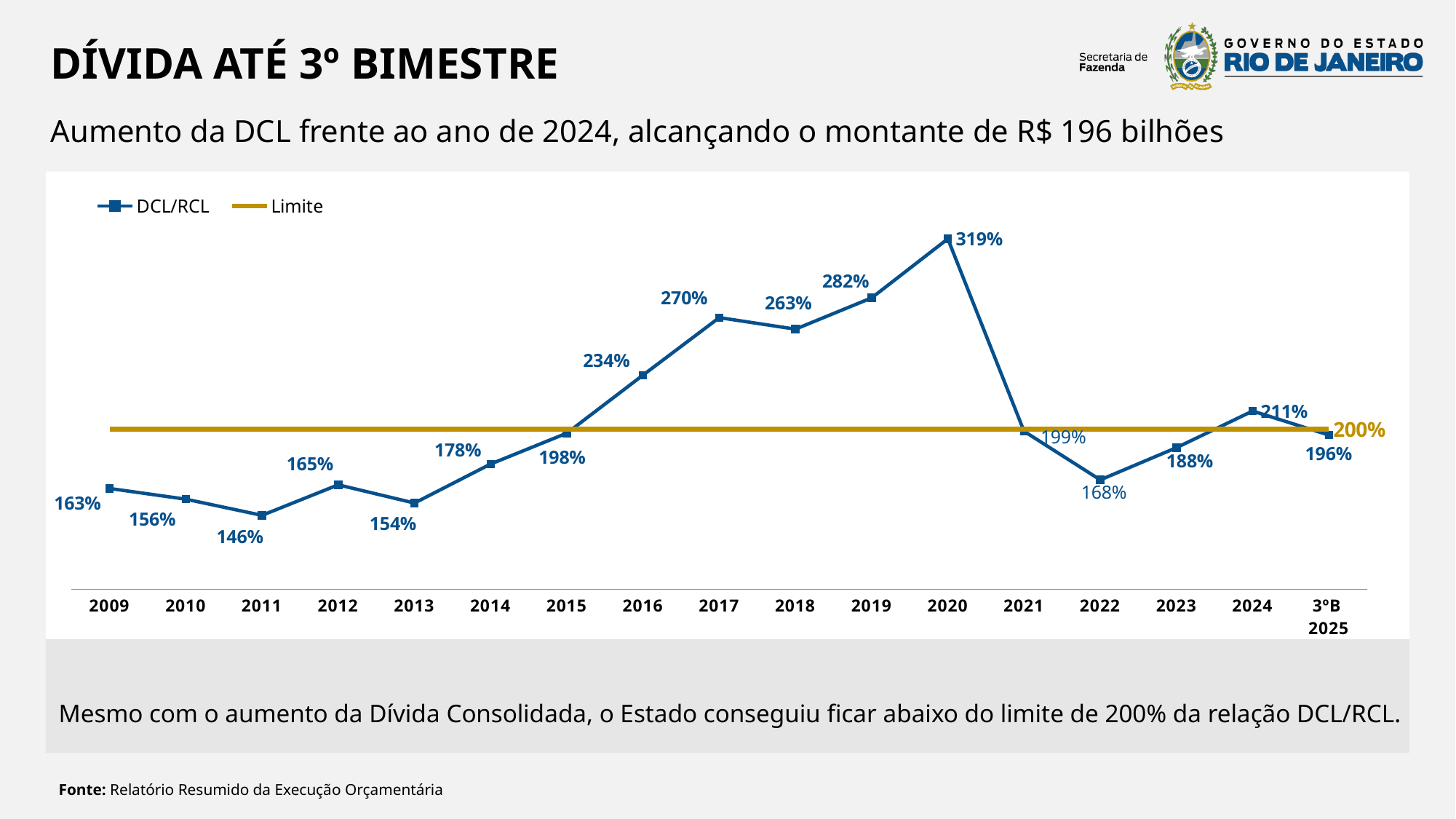
What is the difference between the DCL/RCL values for 2020 and 2021? 120% How many data points does the DCL/RCL series have? 17 Which year has the highest DCL/RCL value? 2020 Does the DCL/RCL value rise or fall from 2013 to 2020? Rise What value does the Limite line represent? 200% What is the DCL/RCL value for 2011? 146% Which is larger, the DCL/RCL value for 2017 or for 2018? 2017 Which year has the lowest DCL/RCL value? 2011 What kind of chart is shown on the slide? Line chart What is the DCL/RCL value for 3ºB 2025? 196% How many series does the legend list? 2 What is the DCL/RCL value for 2020? 319%